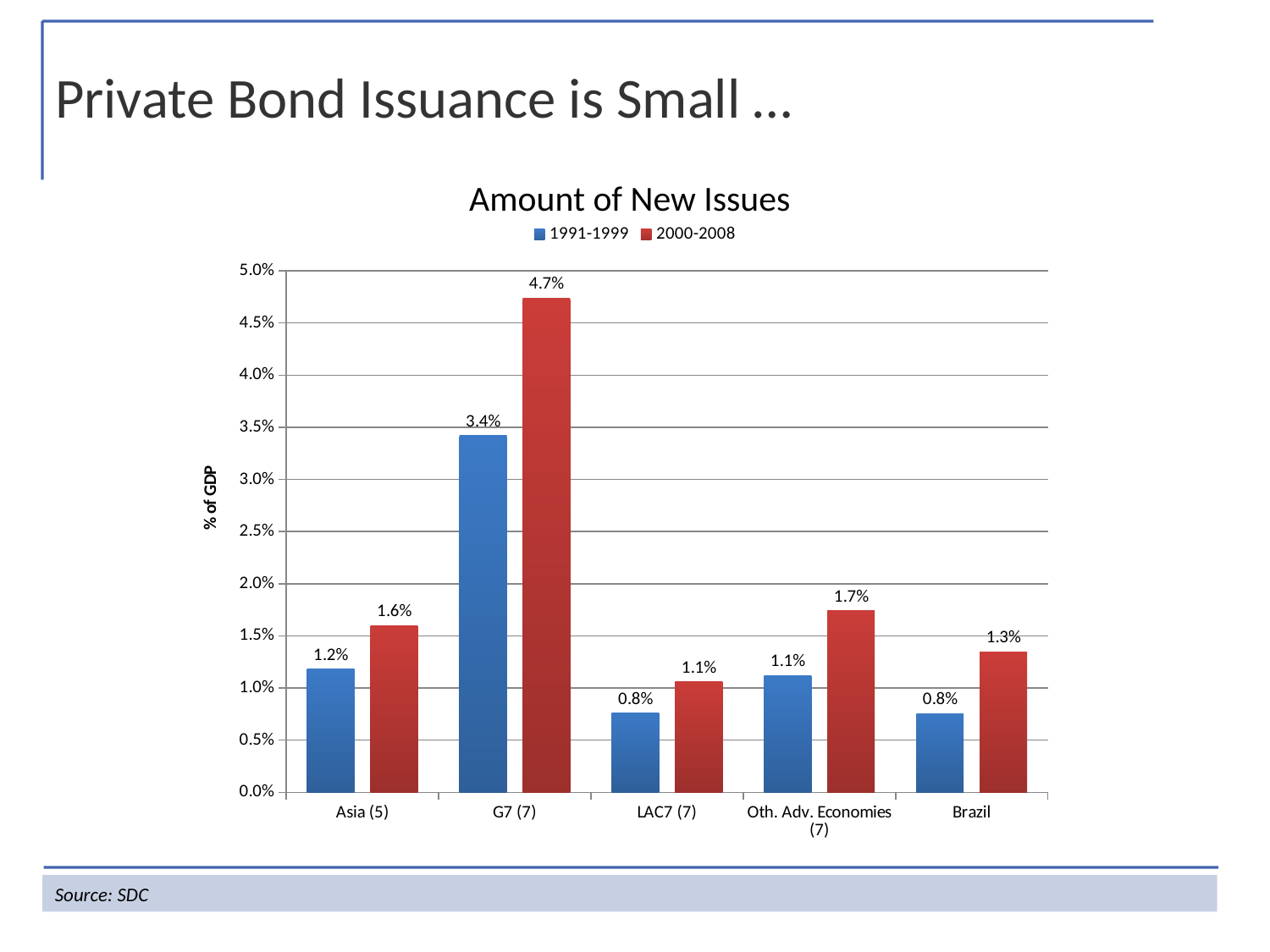
Which is larger for Oth. Adv. Economies (7): the 1991-1999 value or the 2000-2008 value? 2000-2008 What is the value for Asia (5) in the 1991-1999 series? 1.2% How many categories are shown on the x axis? 5 How many series does the legend list? 2 What is the difference between the 2000-2008 and 1991-1999 values for G7 (7)? 1.3% Is the 1991-1999 value for G7 (7) greater or less than 3.0%? greater What kind of chart is shown on the slide? bar chart What is the value for Brazil in the 2000-2008 series? 1.3% What is the value for G7 (7) in the 2000-2008 series? 4.7% Which category has the highest value in the 1991-1999 series? G7 (7) Which category has the lowest value in the 2000-2008 series? LAC7 (7) What is the label of the vertical axis? % of GDP